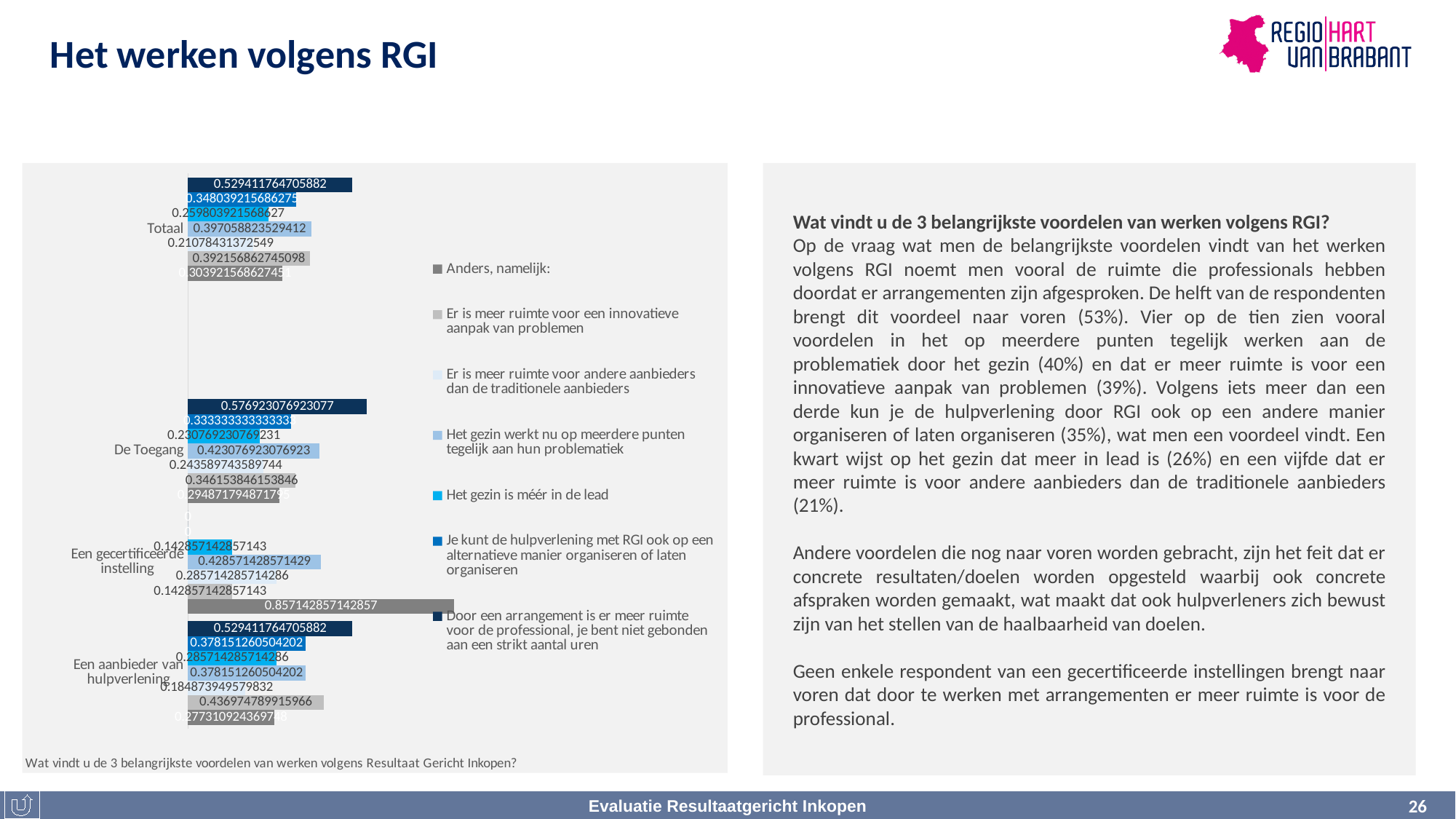
What is the value for 'Er is meer ruimte voor een innovatieve aanpak van problemen' in the Een aanbieder van hulpverlening group? 0.436974789915966 What question is printed below the chart as its caption? Wat vindt u de 3 belangrijkste voordelen van werken volgens Resultaat Gericht Inkopen? What is the value for 'Anders, namelijk:' in the Een gecertificeerde instelling group? 0.857142857142857 What is the value for 'Door een arrangement is er meer ruimte voor de professional, je bent niet gebonden aan een strikt aantal uren' in the Totaal group? 0.529411764705882 How many series does the chart legend list? 7 Which series has the highest value in the Totaal group? Door een arrangement is er meer ruimte voor de professional, je bent niet gebonden aan een strikt aantal uren What kind of chart is shown on the slide? bar chart What is the value for 'Het gezin werkt nu op meerdere punten tegelijk aan hun problematiek' in the De Toegang group? 0.423076923076923 In the De Toegang group, which is larger: 'Door een arrangement is er meer ruimte voor de professional' or 'Je kunt de hulpverlening met RGI ook op een alternatieve manier organiseren of laten organiseren'? Door een arrangement is er meer ruimte voor de professional How many categories (respondent groups) are shown on the chart? 4 What is the difference between 'Door een arrangement is er meer ruimte voor de professional' and 'Je kunt de hulpverlening met RGI ook op een alternatieve manier organiseren' in the Totaal group? 0.181372549019607 Which series has the lowest value in the Totaal group? Er is meer ruimte voor andere aanbieders dan de traditionele aanbieders